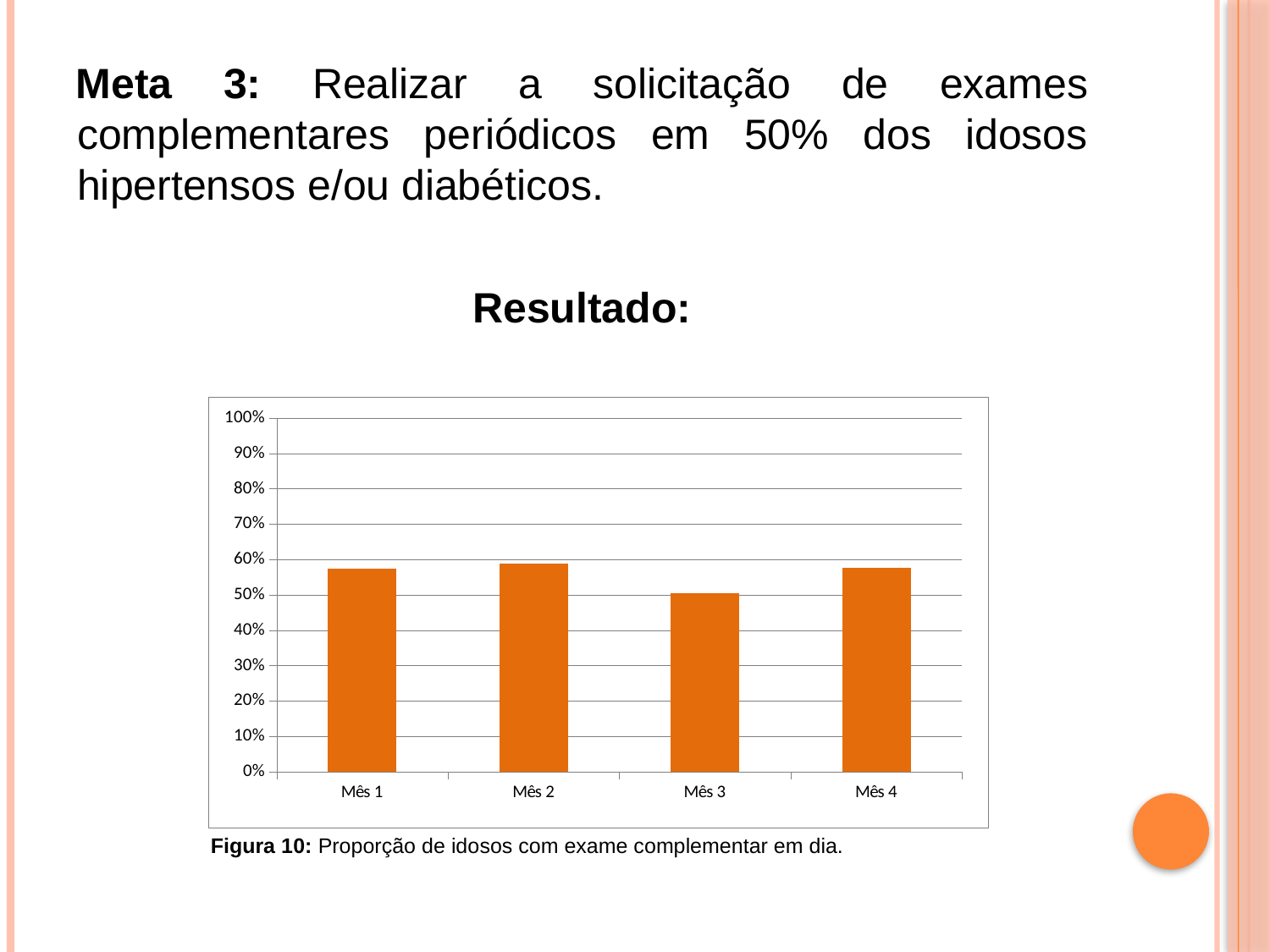
Which month has the highest bar on the chart? Mês 2 Is the value for Mês 3 greater or less than 60%? less Which is larger, the value for Mês 1 or the value for Mês 3? Mês 1 What is the figure caption given below the chart? Figura 10: Proporção de idosos com exame complementar em dia. What kind of chart is shown on the slide? bar chart Which month has the lowest bar on the chart? Mês 3 Is the value for Mês 2 greater or less than 70%? less Which is larger, the value for Mês 2 or the value for Mês 3? Mês 2 Is the value for Mês 4 greater or less than 60%? less How many months (categories) are plotted on the chart? 4 Does the value rise or fall from Mês 2 to Mês 3? fall